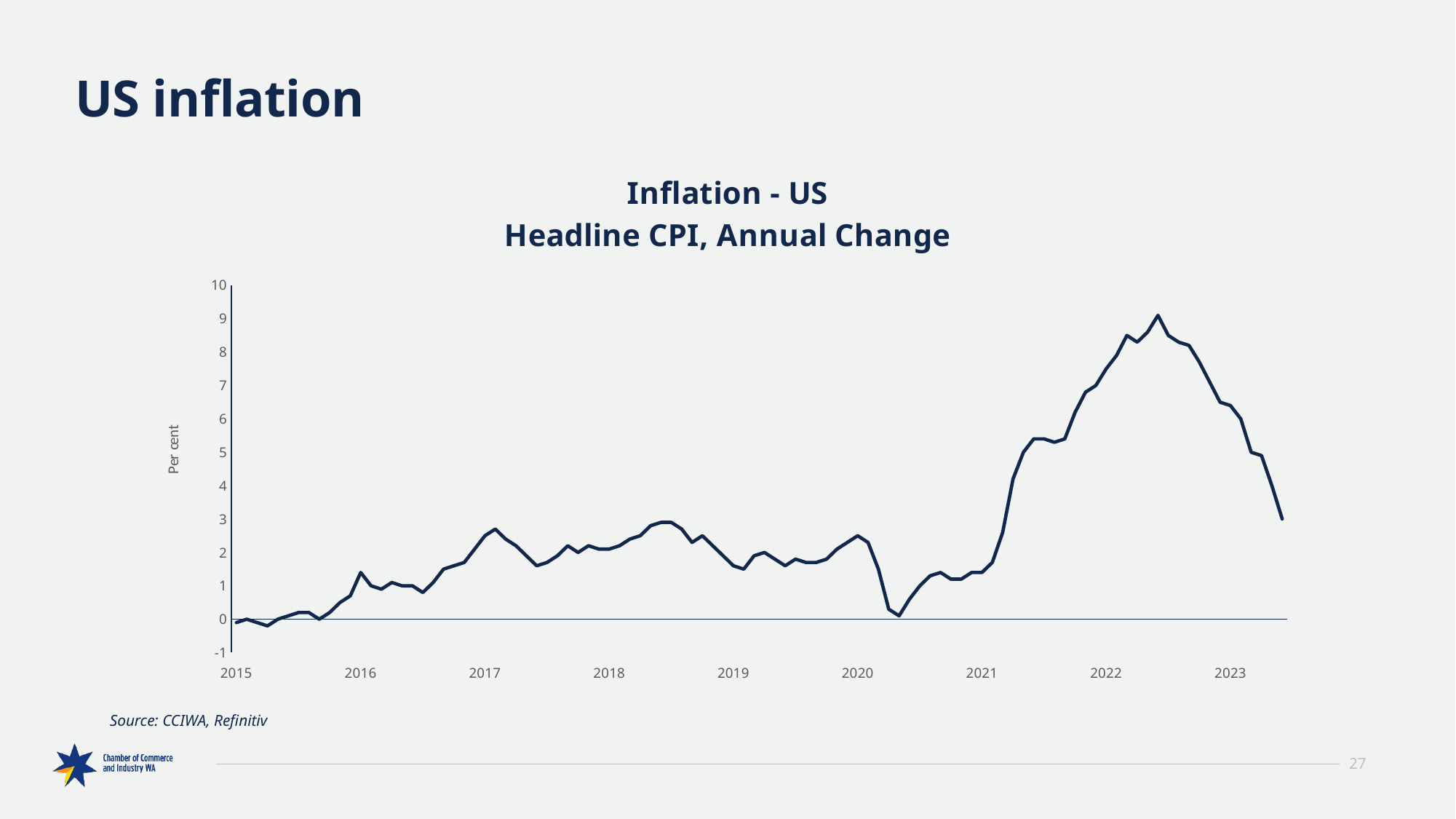
Is the value in mid-2022 larger or smaller than the value in mid-2018? larger What is the title of the chart? Inflation - US Headline CPI, Annual Change Is the lowest value reached in 2020 greater or less than 1? less What kind of chart is shown on the slide? Line chart How many year labels are shown on the horizontal axis? 9 Does the line rise or fall between the start of 2021 and mid-2022? rise Is the peak value of the line in 2022 greater or less than 8? greater What is the label on the vertical axis of the chart? Per cent In which year does the line reach its highest point? 2022 Is the value at the start of 2015 greater or less than 1? less Does the line rise or fall from its 2022 peak to the end of the series in 2023? fall